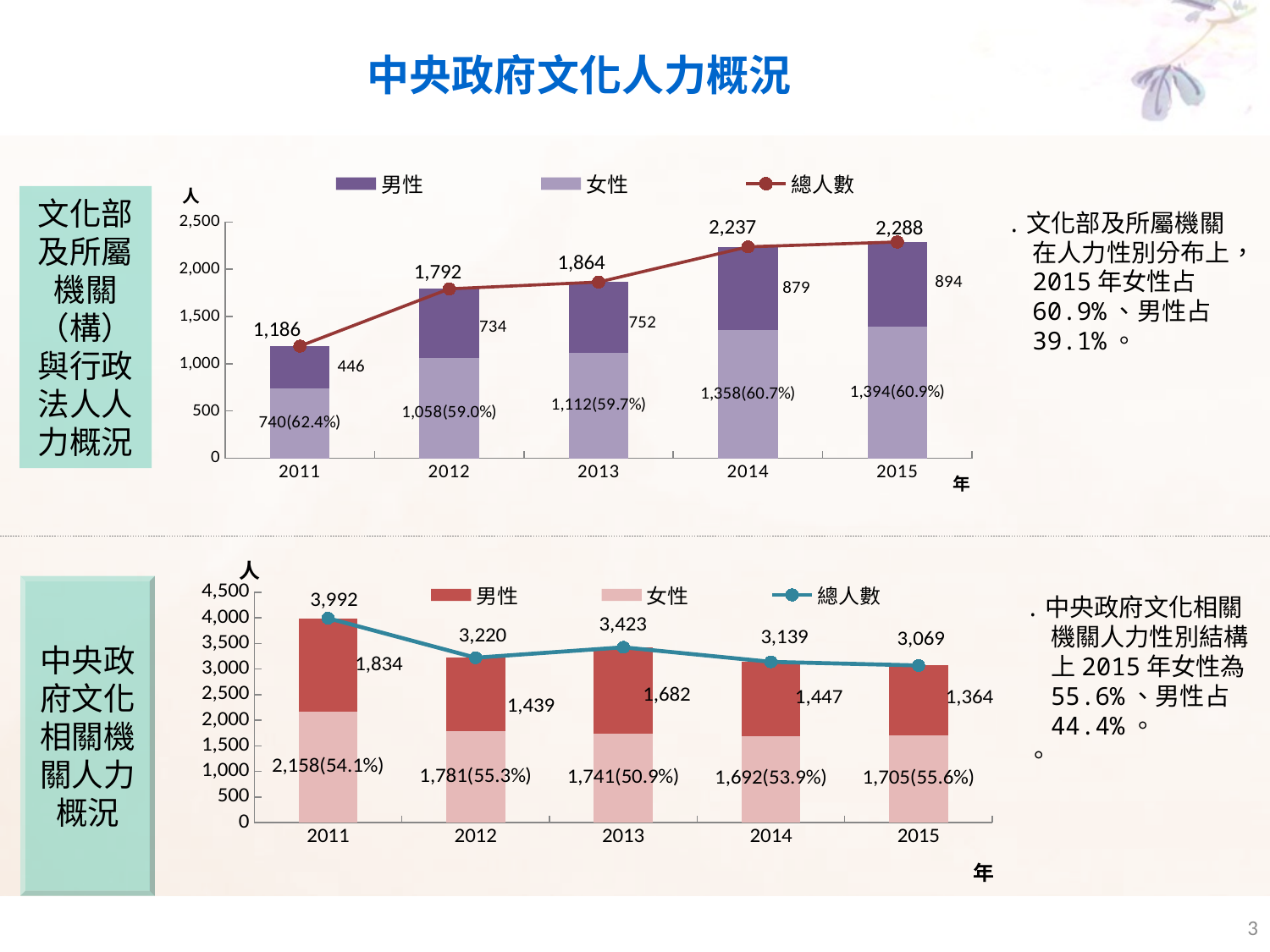
In the bottom chart, which year has the highest 總人數? 2011 In the top chart, which year has the lowest 總人數? 2011 In the bottom chart, which is larger, the 男性 value for 2012 or for 2014? 2014 In the top chart, what is the 總人數 value for 2015? 2,288 In the bottom chart, what is the 總人數 value for 2011? 3,992 In the top chart, what is the difference in 總人數 between 2015 and 2011? 1,102 In the top chart, does the 總人數 line rise or fall from 2011 to 2015? rise In the top chart, what is the 男性 value for 2014? 879 In the bottom chart, what is the 男性 value for 2013? 1,682 How many series does the legend of the bottom chart list? 3 In the bottom chart, what is the difference in 總人數 between 2013 and 2012? 203 In the top chart, what is the data label on the 女性 segment for 2011? 740(62.4%)